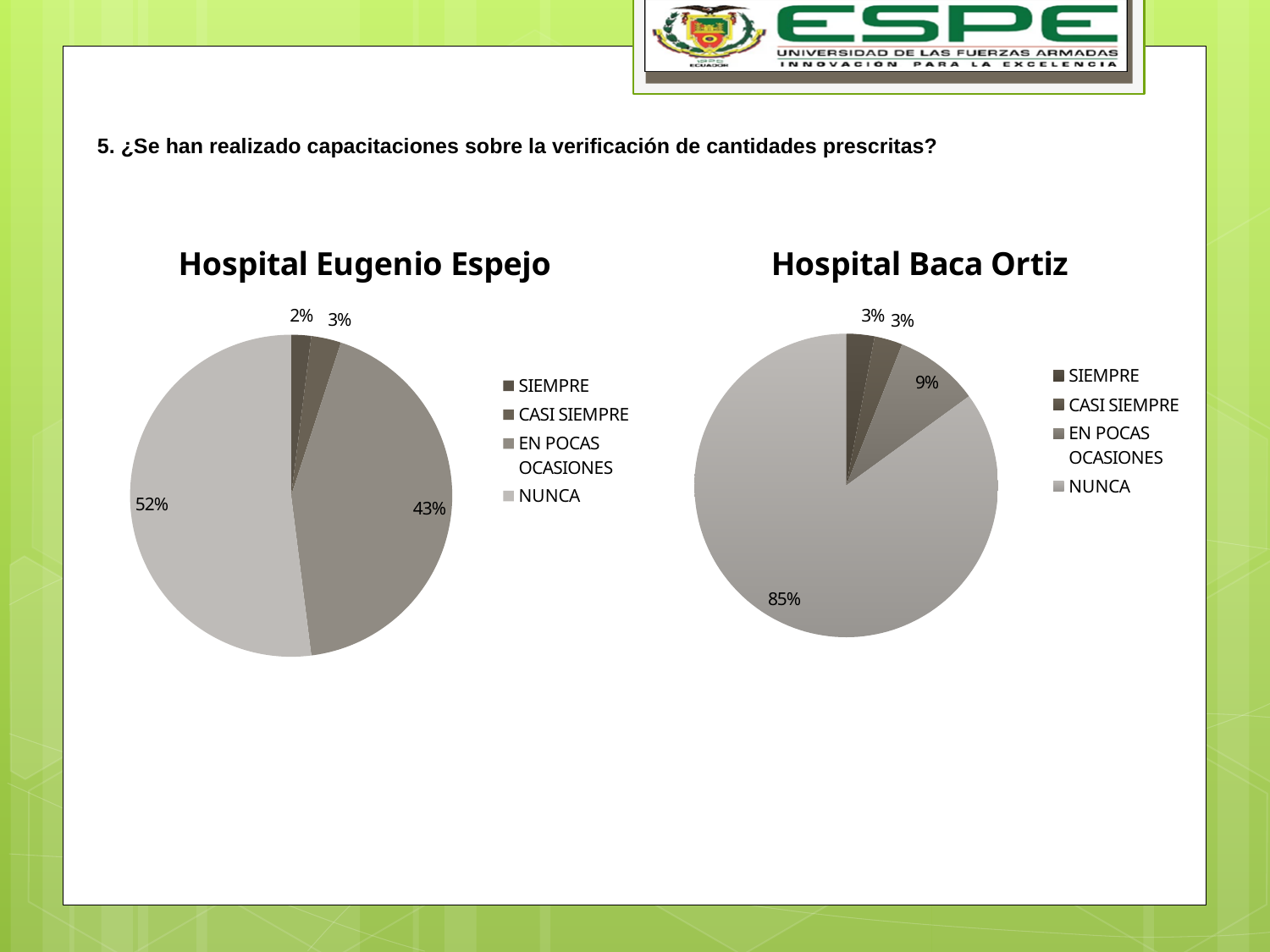
In the Hospital Baca Ortiz chart, which category has the largest share? NUNCA In the Hospital Eugenio Espejo chart, what percentage corresponds to NUNCA? 52% How many categories does the Hospital Baca Ortiz chart show? 4 In the Hospital Baca Ortiz chart, what percentage corresponds to NUNCA? 85% In the Hospital Eugenio Espejo chart, which category has the smallest share? SIEMPRE In the Hospital Eugenio Espejo chart, what percentage corresponds to EN POCAS OCASIONES? 43% In the Hospital Eugenio Espejo chart, what is the difference between the NUNCA and EN POCAS OCASIONES shares? 9% What is the title of the chart on the right side of the slide? Hospital Baca Ortiz What type of chart is used for Hospital Eugenio Espejo? Pie chart In the Hospital Eugenio Espejo chart, which category has the largest share? NUNCA In the Hospital Baca Ortiz chart, what percentage corresponds to EN POCAS OCASIONES? 9% Which hospital has the larger NUNCA share, Hospital Eugenio Espejo or Hospital Baca Ortiz? Hospital Baca Ortiz